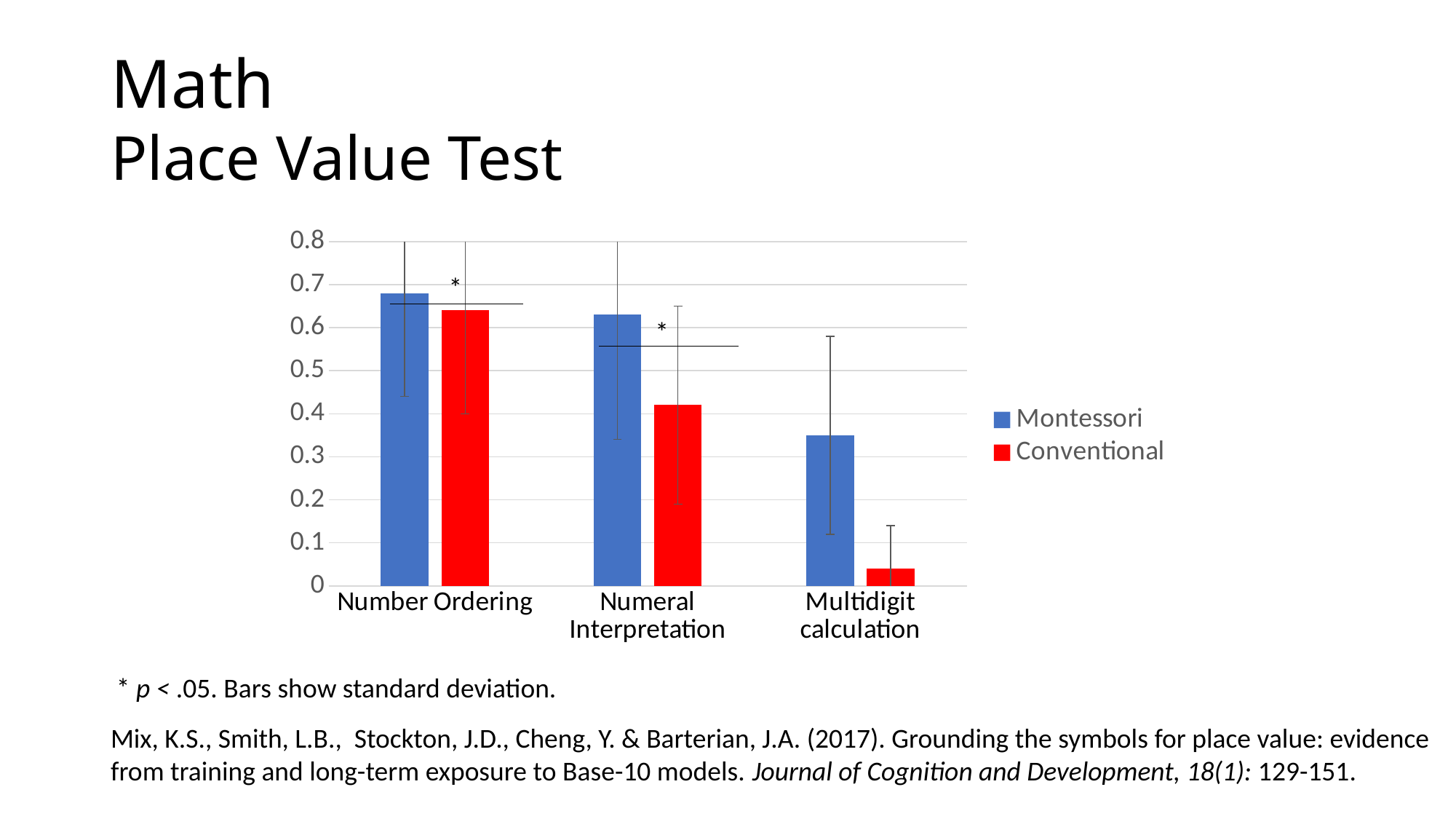
What kind of chart is shown on the slide? bar chart Do the Conventional values rise or fall from Number Ordering to Multidigit calculation? fall For Numeral Interpretation, which is larger: Montessori or Conventional? Montessori Is the Montessori value for Number Ordering greater or less than 0.6? greater Which category has the lowest Montessori value? Multidigit calculation Which category has the highest Conventional value? Number Ordering Is the Conventional value for Multidigit calculation greater or less than 0.1? less Which series is shown in red? Conventional For Multidigit calculation, which is larger: Montessori or Conventional? Montessori How many categories are shown on the x axis? 3 How many series does the legend list? 2 Which category has the lowest Conventional value? Multidigit calculation